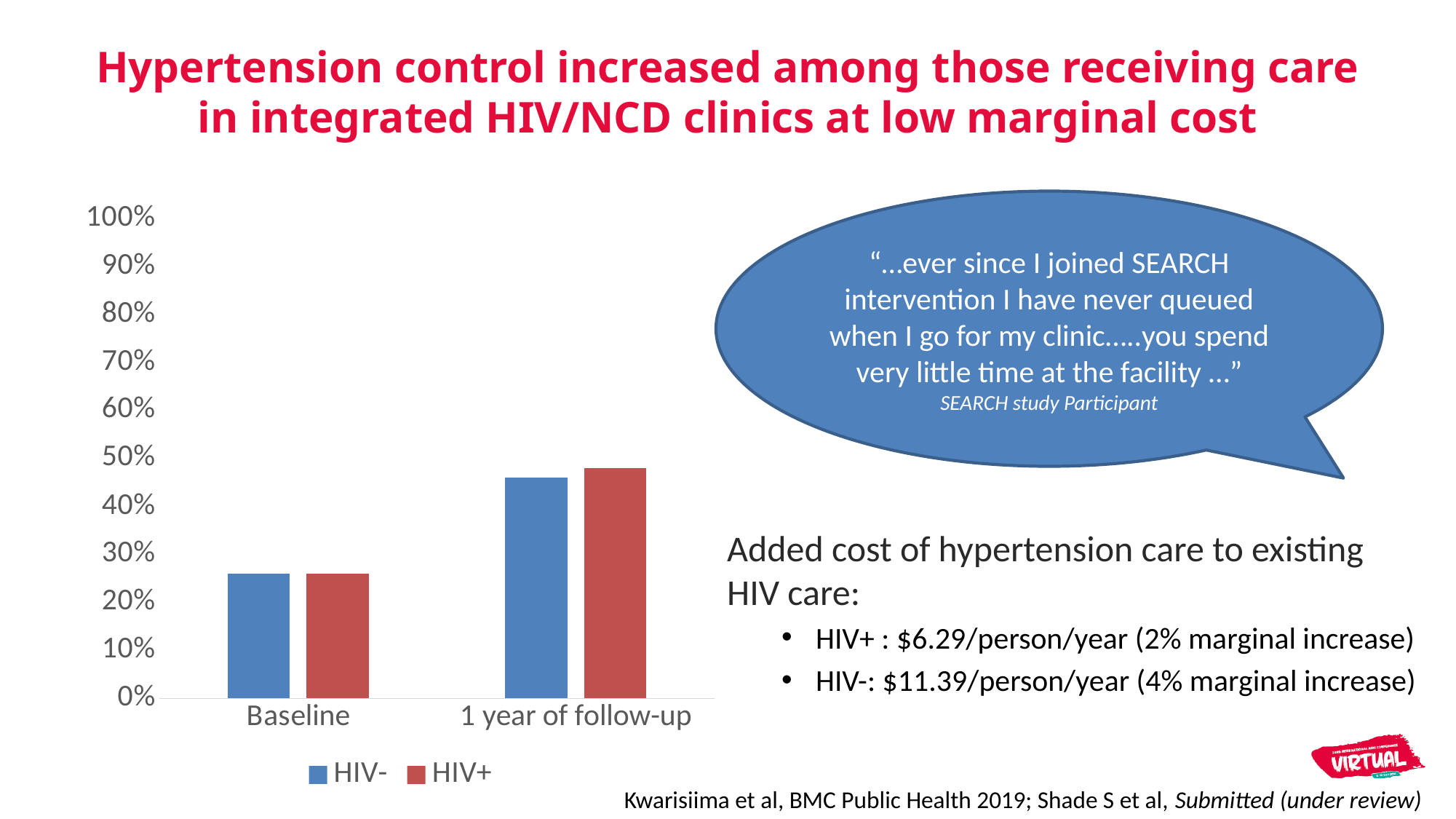
Do the values for the HIV+ series rise or fall from Baseline to 1 year of follow-up? rise How many categories are shown on the x axis of the chart? 2 How many series does the chart legend list? 2 What are the two series named in the chart legend? HIV- and HIV+ Is the HIV- value at Baseline greater or less than 30%? less What kind of chart is shown on the slide? bar chart Which colour represents the HIV+ series in the chart? red Is the HIV- value at 1 year of follow-up greater or less than 40%? greater Is the HIV+ value at Baseline greater or less than 30%? less For the HIV- series, which is larger: the value at Baseline or at 1 year of follow-up? 1 year of follow-up